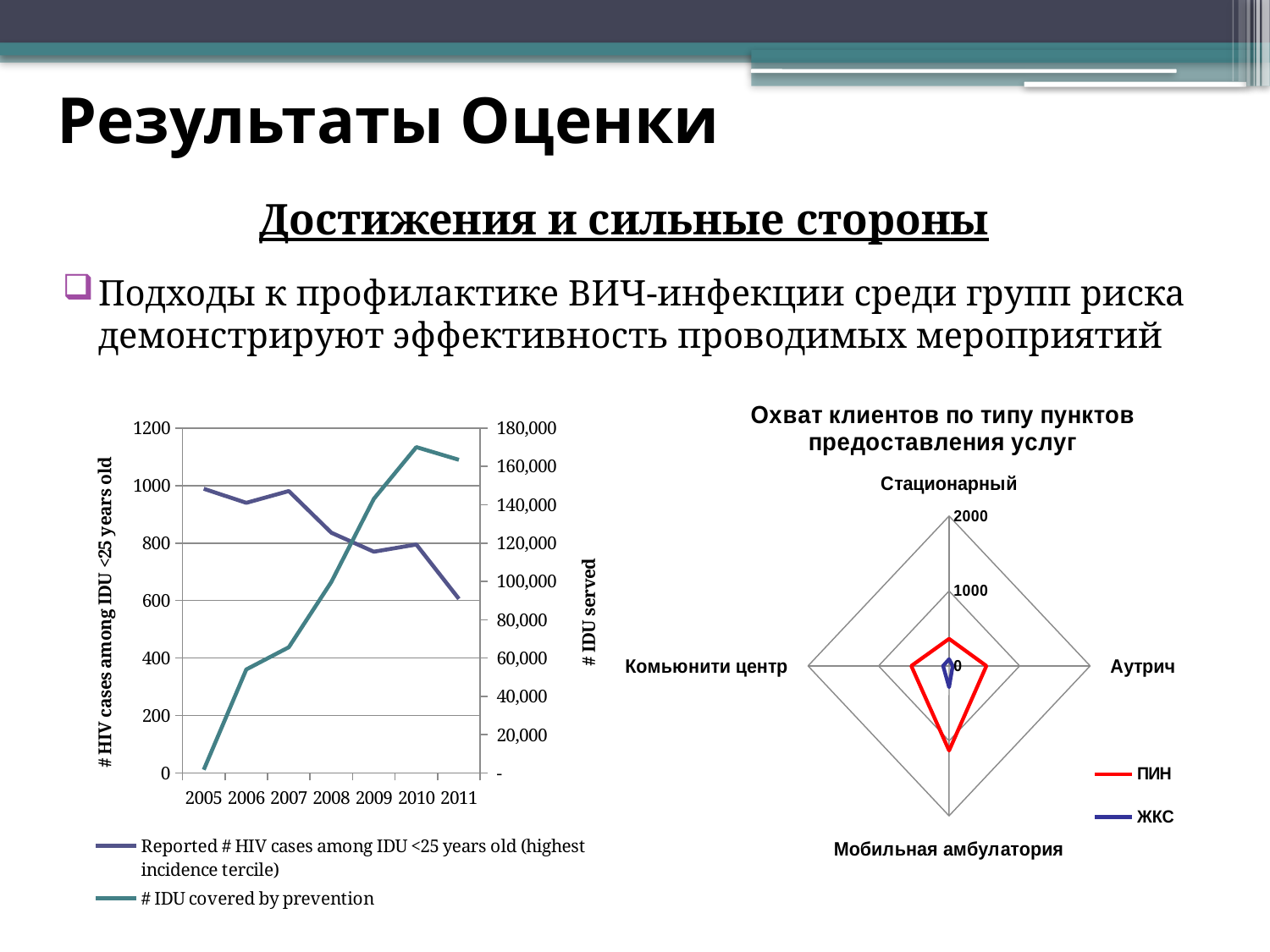
In the line chart on the left, is the value of 'Reported # HIV cases among IDU <25 years old' in 2011 greater or less than 800? less What kind of chart is the chart on the left of the slide? line chart How many series does the legend of the line chart on the left list? 2 In the radar chart 'Охват клиентов по типу пунктов предоставления услуг', which series has the larger value for 'Мобильная амбулатория', ПИН or ЖКС? ПИН How many categories (axes) does the radar chart 'Охват клиентов по типу пунктов предоставления услуг' have? 4 In the line chart on the left, in which year is 'Reported # HIV cases among IDU <25 years old' lowest? 2011 In the line chart on the left, is the value of '# IDU covered by prevention' in 2010 greater or less than 140,000? greater In the line chart on the left, how many years are shown on the x axis? 7 In the line chart on the left, does the series 'Reported # HIV cases among IDU <25 years old' rise or fall overall from 2005 to 2011? fall How many series does the legend of the chart 'Охват клиентов по типу пунктов предоставления услуг' list? 2 What kind of chart is the chart titled 'Охват клиентов по типу пунктов предоставления услуг'? radar chart In the line chart on the left, does the series '# IDU covered by prevention' rise or fall from 2005 to 2010? rise